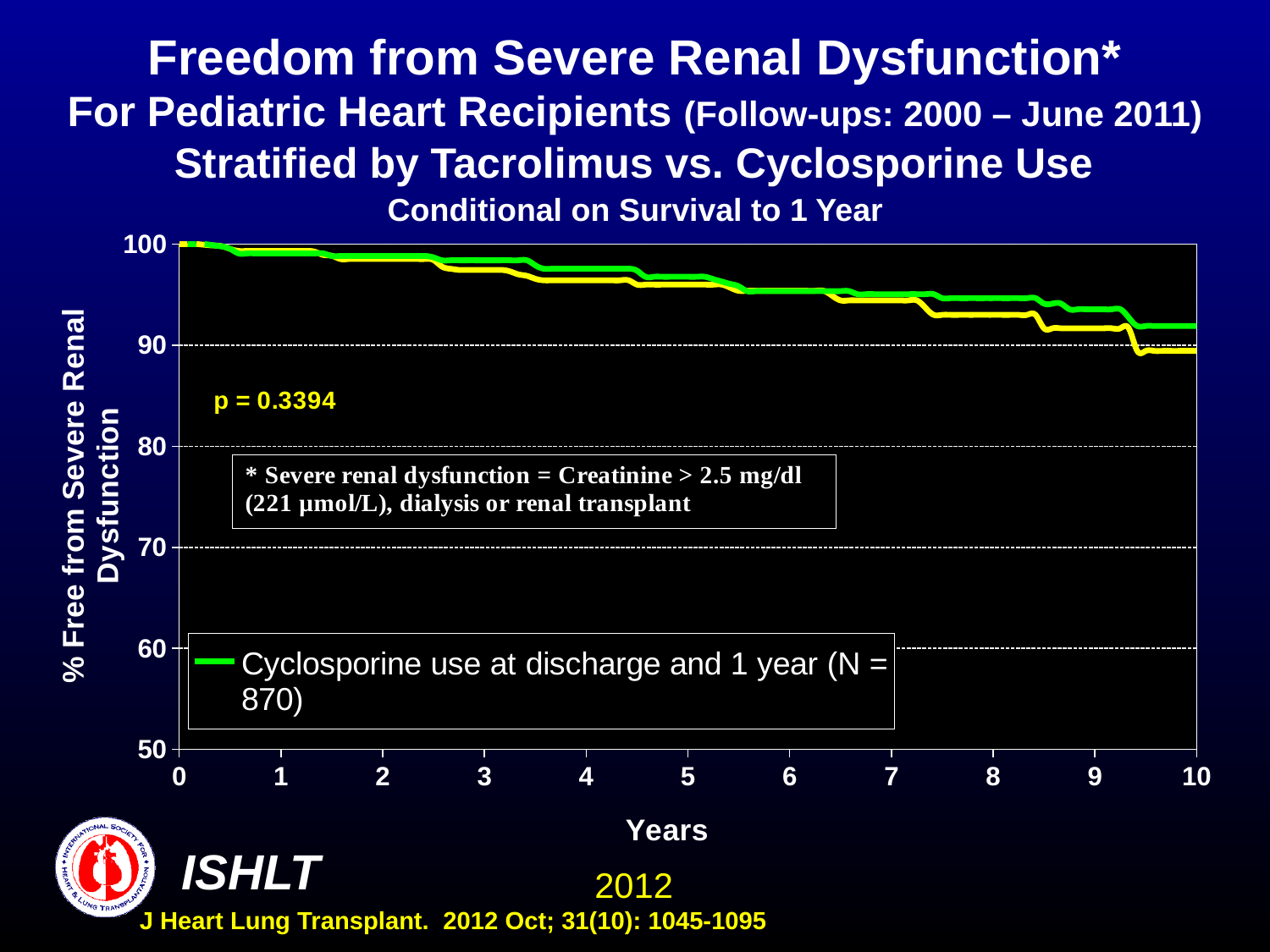
At what value do both lines start at year 0? 100 Is the value of the green (Cyclosporine) line at year 5 greater or less than 90? greater Is the value of the green (Cyclosporine) line at year 10 greater or less than 90? greater Do the plotted lines rise or fall as the years increase along the x axis? fall What is the N for the Cyclosporine use at discharge and 1 year group shown in the legend? 870 At year 7, which line is higher, the green line or the yellow line? green line Is the value of the yellow line at year 10 greater or less than 95? less What kind of chart is shown on the slide? line chart What p-value is printed on the chart? p = 0.3394 At year 10, which line is higher, the green line or the yellow line? green line